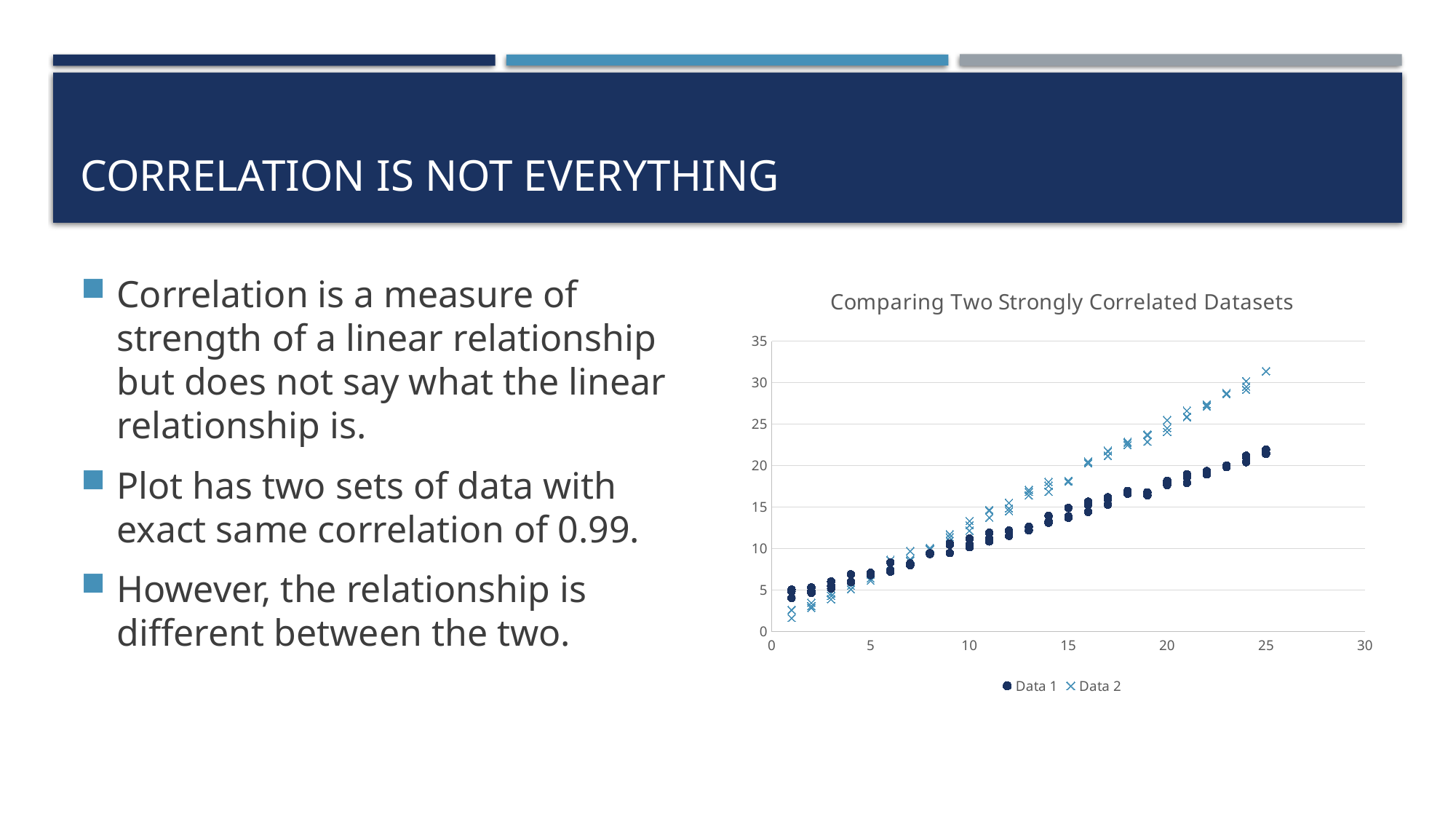
What kind of chart is shown on the slide? scatter chart What is the title of the chart? Comparing Two Strongly Correlated Datasets How many series does the chart's legend list? 2 At x = 25, which series has the larger y value, Data 1 or Data 2? Data 2 Is the y value for Data 2 at x = 25 greater or less than 25? greater Is the y value for Data 1 at x = 10 greater or less than 15? less What are the names of the two series in the chart's legend? Data 1 and Data 2 Which series reaches the highest y value on the chart? Data 2 Do the values of Data 2 rise or fall as x increases? rise At x = 1, which series has the larger y value, Data 1 or Data 2? Data 1 Is the y value for Data 1 at x = 25 greater or less than 25? less Do the values of Data 1 rise or fall as x increases? rise